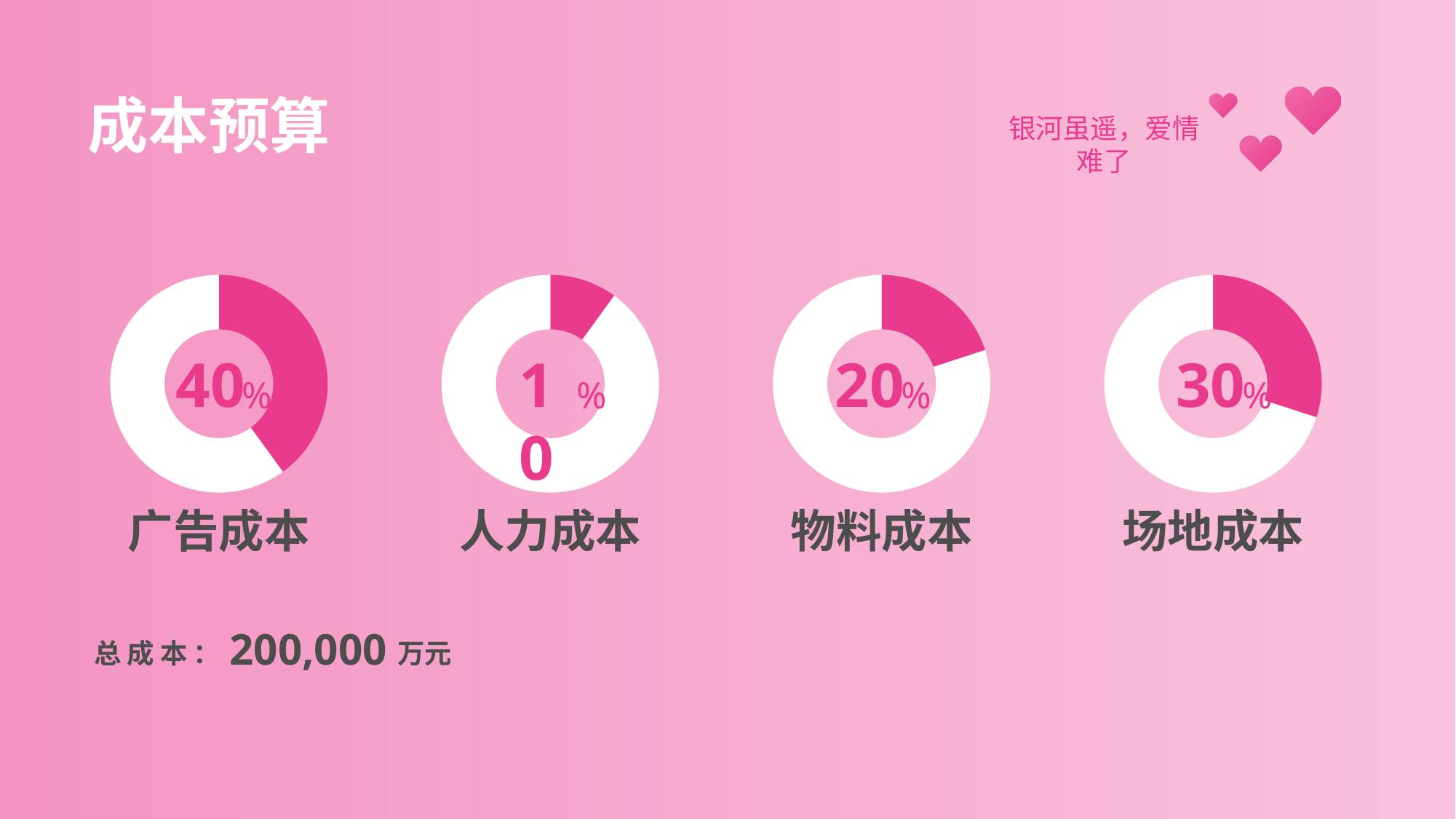
Which cost category has the highest percentage? 广告成本 What percentage is shown for 广告成本? 40% What is the title of the slide? 成本预算 Which is larger, the percentage for 场地成本 or for 物料成本? 场地成本 What is the difference in percentage points between 广告成本 and 物料成本? 20 How many donut charts are shown on the slide? 4 Which is larger, the percentage for 广告成本 or for 场地成本? 广告成本 What is the difference in percentage points between 场地成本 and 物料成本? 10 What kind of chart is used to show each cost category? Donut chart What percentage is shown for 物料成本? 20% What percentage is shown for 场地成本? 30% Which cost category has the lowest percentage? 人力成本